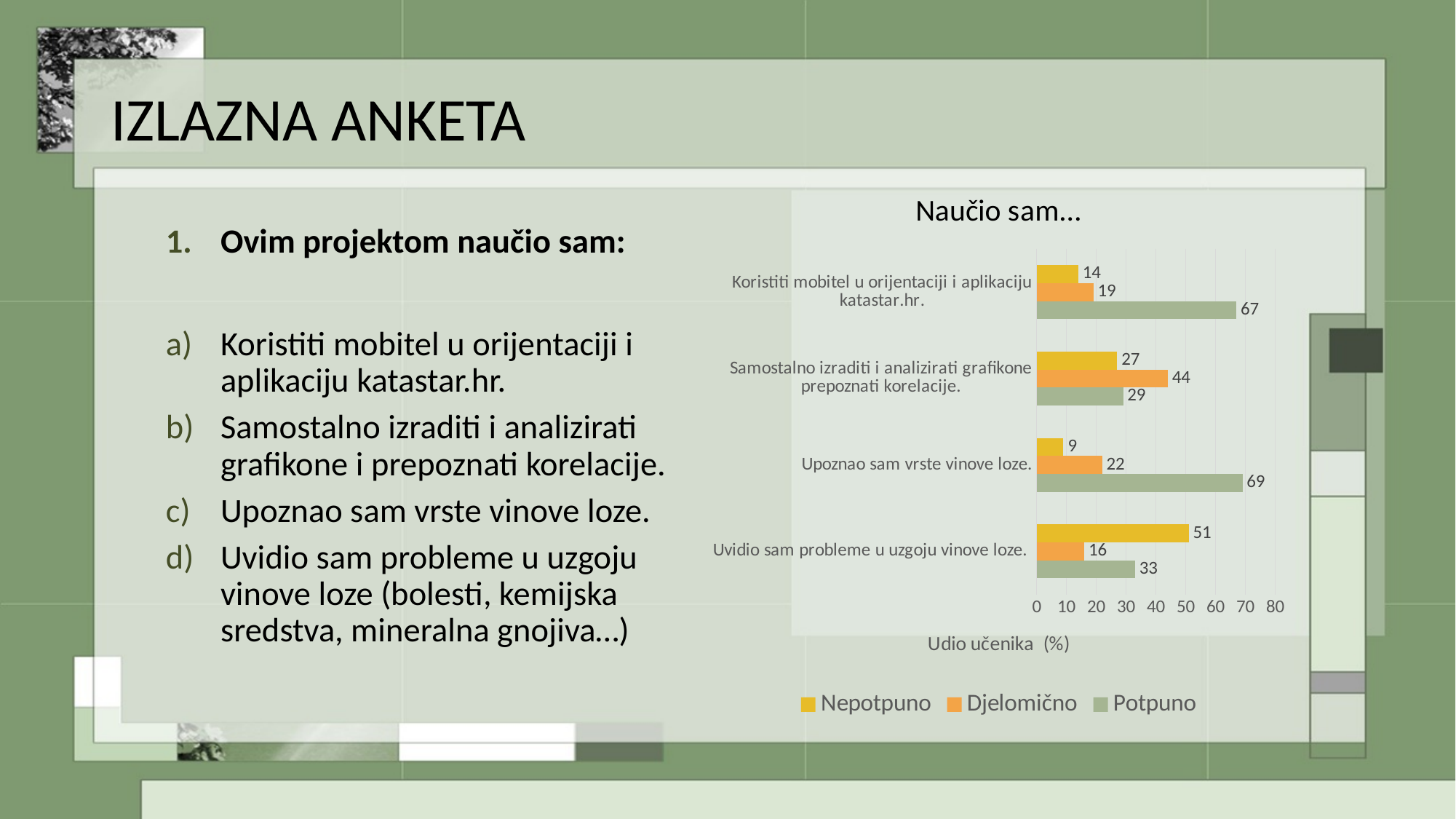
What is the Nepotpuno value for "Uvidio sam probleme u uzgoju vinove loze."? 51 How many series does the chart legend list? 3 What is the difference between the Potpuno and Nepotpuno values for "Koristiti mobitel u orijentaciji i aplikaciju katastar.hr."? 53 Which category has the lowest Nepotpuno value? Upoznao sam vrste vinove loze. Which is larger for "Uvidio sam probleme u uzgoju vinove loze.": the Nepotpuno value or the Potpuno value? Nepotpuno What is the Djelomično value for "Samostalno izraditi i analizirati grafikone i prepoznati korelacije."? 44 Which category has the highest Potpuno value? Upoznao sam vrste vinove loze. What kind of chart is shown on the slide? bar chart What is the label of the horizontal axis? Udio učenika (%) What is the title of the chart? Naučio sam... How many categories are shown on the chart? 4 What is the Potpuno value for "Upoznao sam vrste vinove loze."? 69